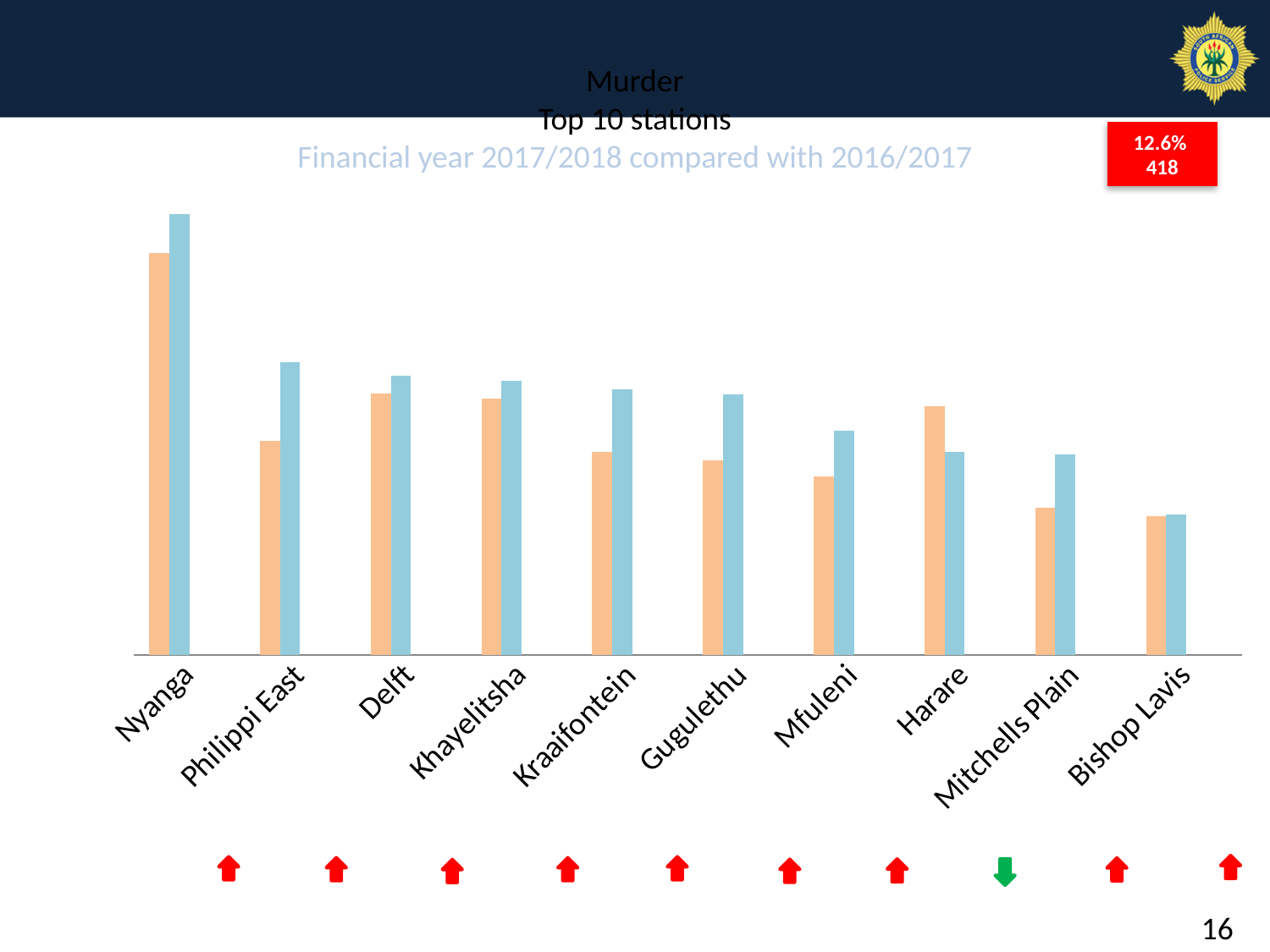
Which station has a taller orange bar, Delft or Kraaifontein? Delft How many stations are shown on the x axis of the chart? 10 Which station has the shortest blue bar in the chart? Bishop Lavis Which station is marked with a green downward arrow below the chart? Harare Which station has a taller blue bar, Philippi East or Mfuleni? Philippi East What kind of chart is shown on the slide? bar chart What crime type is named in the chart title? Murder Which station has the tallest bars in the chart? Nyanga For Mitchells Plain, which bar is taller, the orange bar or the blue bar? blue Do the blue bars generally rise or fall from left to right along the x axis? fall